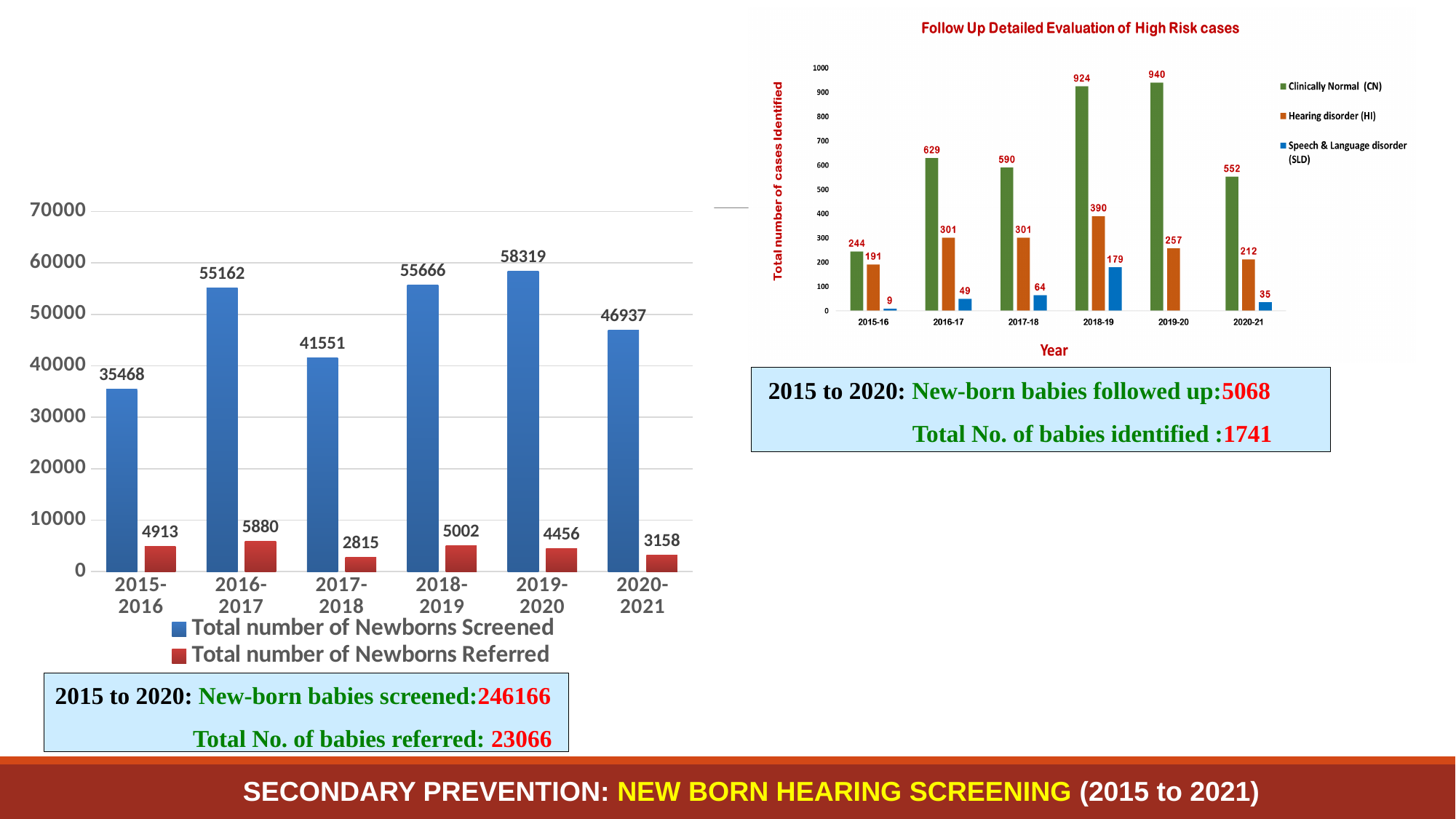
In the left chart, what is the total number of newborns screened in 2018-2019? 55666 What kind of chart is the chart titled 'Follow Up Detailed Evaluation of High Risk cases'? Bar chart In the left chart, what is the total number of newborns referred in 2017-2018? 2815 In the chart titled 'Follow Up Detailed Evaluation of High Risk cases', which year has the highest number of Hearing disorder (HI) cases? 2018-19 In the left chart, which year has the highest total number of newborns screened? 2019-2020 In the left chart, which year has the lowest total number of newborns referred? 2017-2018 In the left chart, how many series does the legend list? 2 In the chart titled 'Follow Up Detailed Evaluation of High Risk cases', how many Speech & Language disorder (SLD) cases were identified in 2018-19? 179 In the chart titled 'Follow Up Detailed Evaluation of High Risk cases', is the Hearing disorder (HI) value for 2016-17 or 2020-21 larger? 2016-17 In the left chart, what is the difference between newborns screened in 2019-2020 and 2020-2021? 11382 In the chart titled 'Follow Up Detailed Evaluation of High Risk cases', how many years are shown on the x axis? 6 In the chart titled 'Follow Up Detailed Evaluation of High Risk cases', how many Clinically Normal (CN) cases were identified in 2019-20? 940